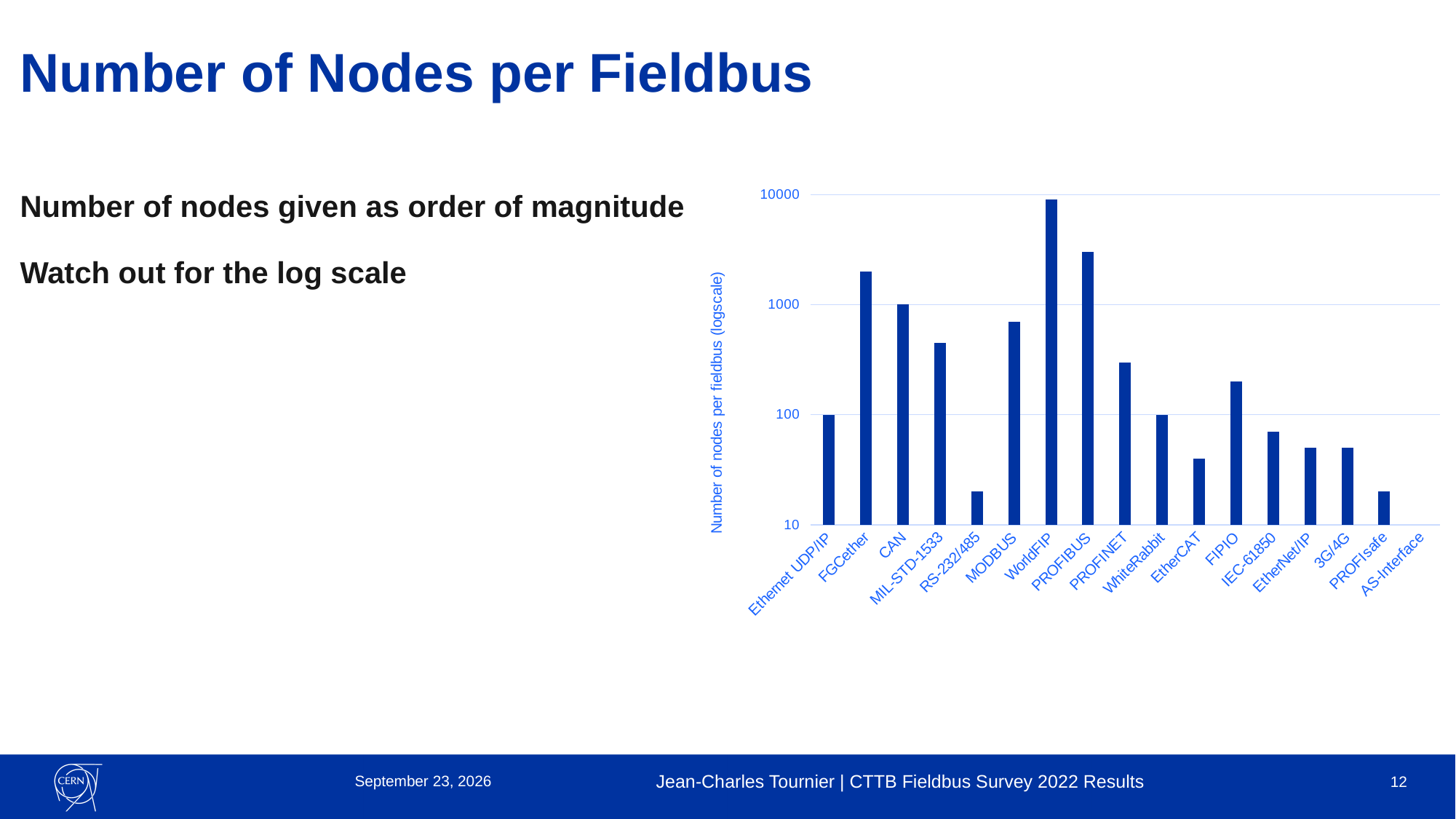
How many fieldbus categories are listed on the x axis? 17 What is the label of the vertical axis? Number of nodes per fieldbus (logscale) Which has more nodes, WorldFIP or PROFIBUS? WorldFIP What kind of chart is shown on the slide? bar chart Is the value for MODBUS greater or less than 1000? less Is the value for EtherCAT greater or less than 100? less Which has more nodes, MODBUS or MIL-STD-1533? MODBUS What is the number of nodes for CAN? 1000 What is the number of nodes for Ethernet UDP/IP? 100 Which fieldbus has the highest number of nodes? WorldFIP Is the value for FIPIO greater or less than 100? greater